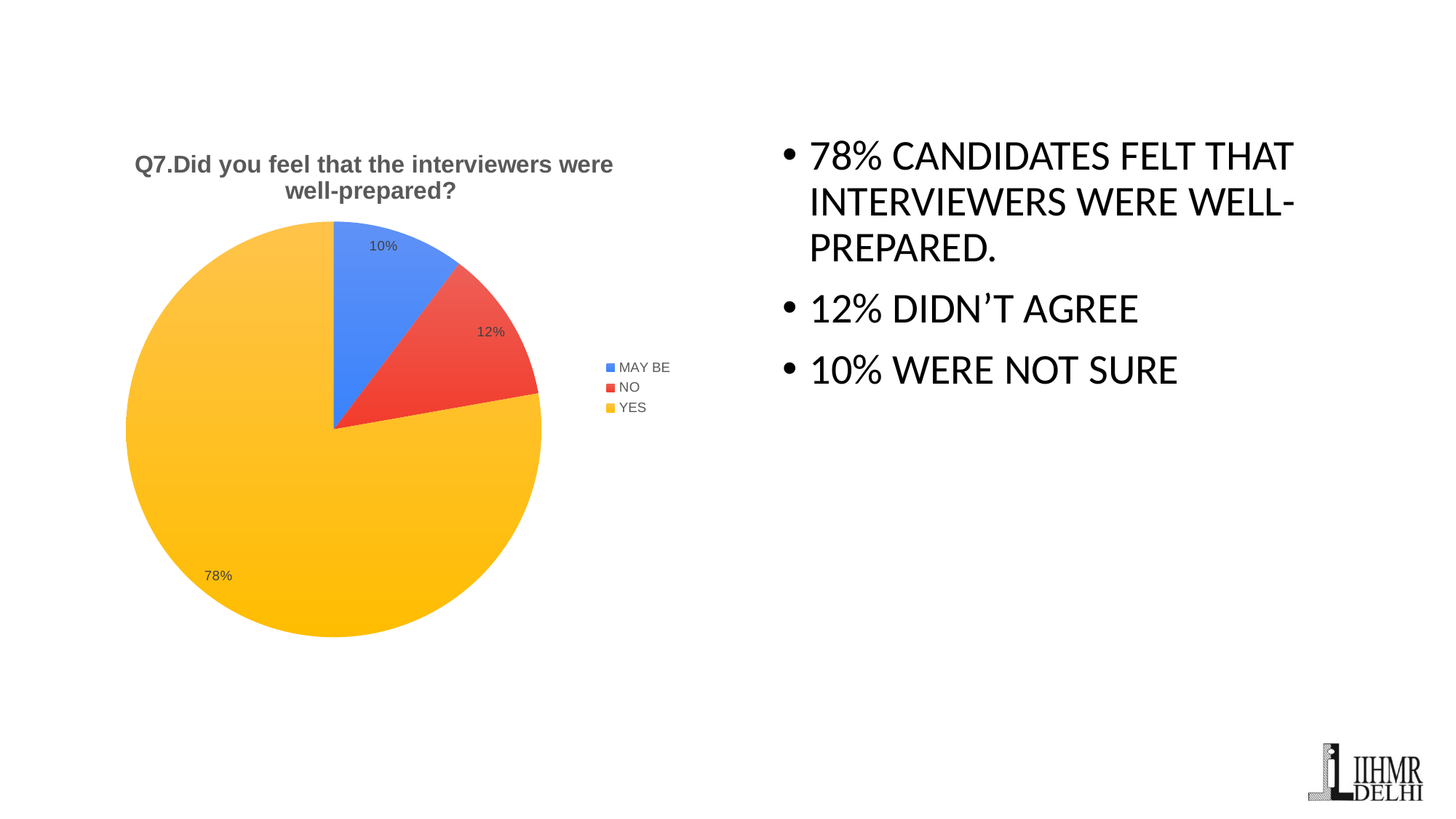
What percentage of the pie is the MAY BE slice? 10% What percentage of the pie is the NO slice? 12% How many categories does the pie chart have? 3 What colour is the YES slice? yellow What is the difference in percentage points between the YES and NO slices? 66 Which category has the smallest share of the pie? MAY BE Which category has the largest share of the pie? YES What type of chart is shown on the slide? pie chart What is the title of the chart? Q7.Did you feel that the interviewers were well-prepared? How many entries does the legend list? 3 What percentage of the pie is the YES slice? 78% Which slice is larger, NO or MAY BE? NO